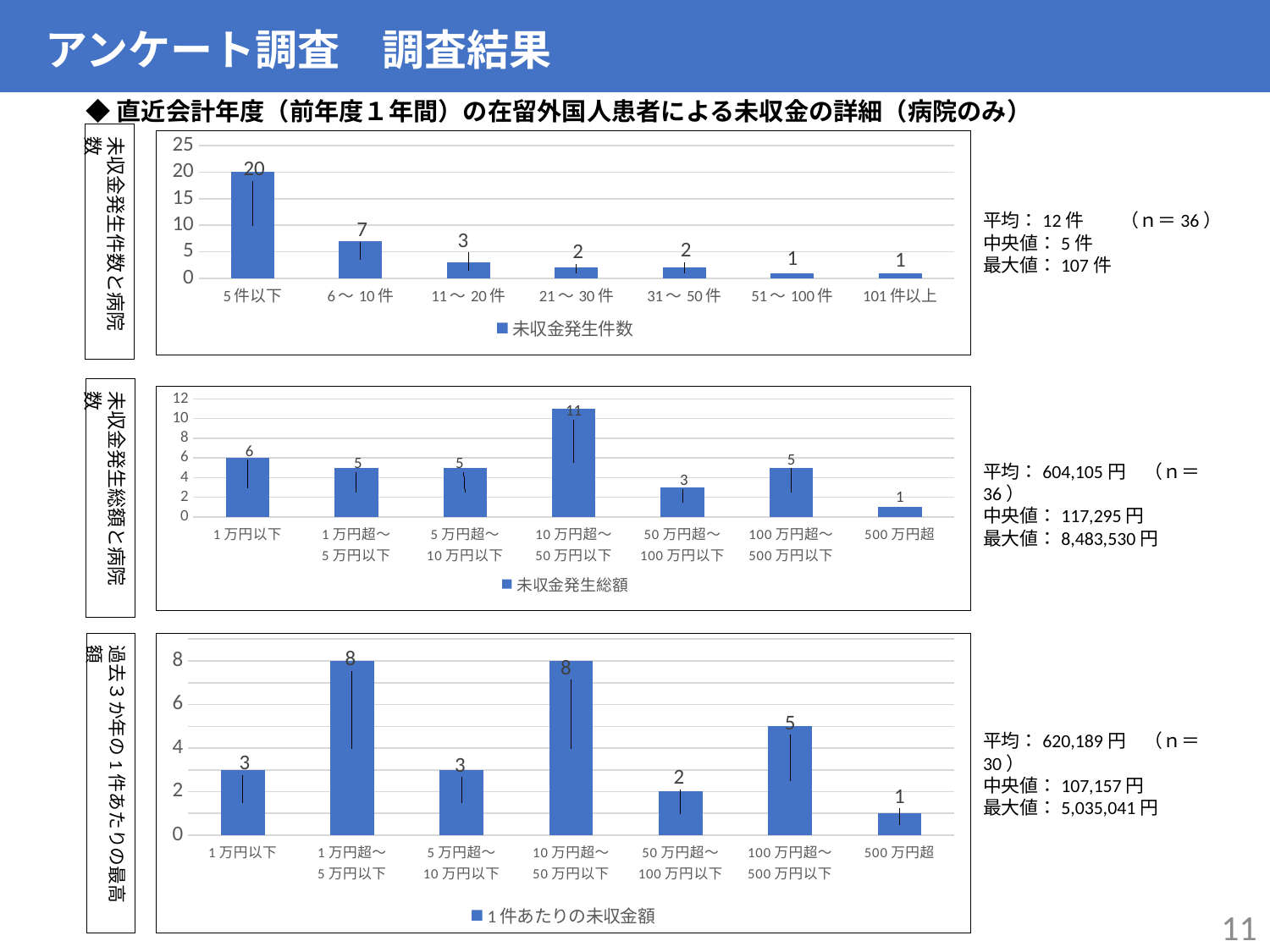
In the bottom chart (1件あたりの未収金額), what is the difference between the values for 1万円超～5万円以下 and 50万円超～100万円以下? 6 In the middle chart (未収金発生総額), which is larger, the value for 1万円以下 or the value for 50万円超～100万円以下? 1万円以下 In the top chart (未収金発生件数), how many categories are shown on the x axis? 7 What kind of chart is the bottom chart (1件あたりの未収金額)? Bar chart In the bottom chart (1件あたりの未収金額), how many series does the legend list? 1 In the middle chart (未収金発生総額), what is the value for 10万円超～50万円以下? 11 In the top chart (未収金発生件数), what is the value for 5件以下? 20 In the top chart (未収金発生件数), which category has the highest value? 5件以下 In the top chart (未収金発生件数), what is the difference between the values for 5件以下 and 6～10件? 13 In the middle chart (未収金発生総額), which category has the lowest value? 500万円超 In the middle chart (未収金発生総額), what is the legend entry? 未収金発生総額 In the bottom chart (1件あたりの未収金額), what is the value for 100万円超～500万円以下? 5